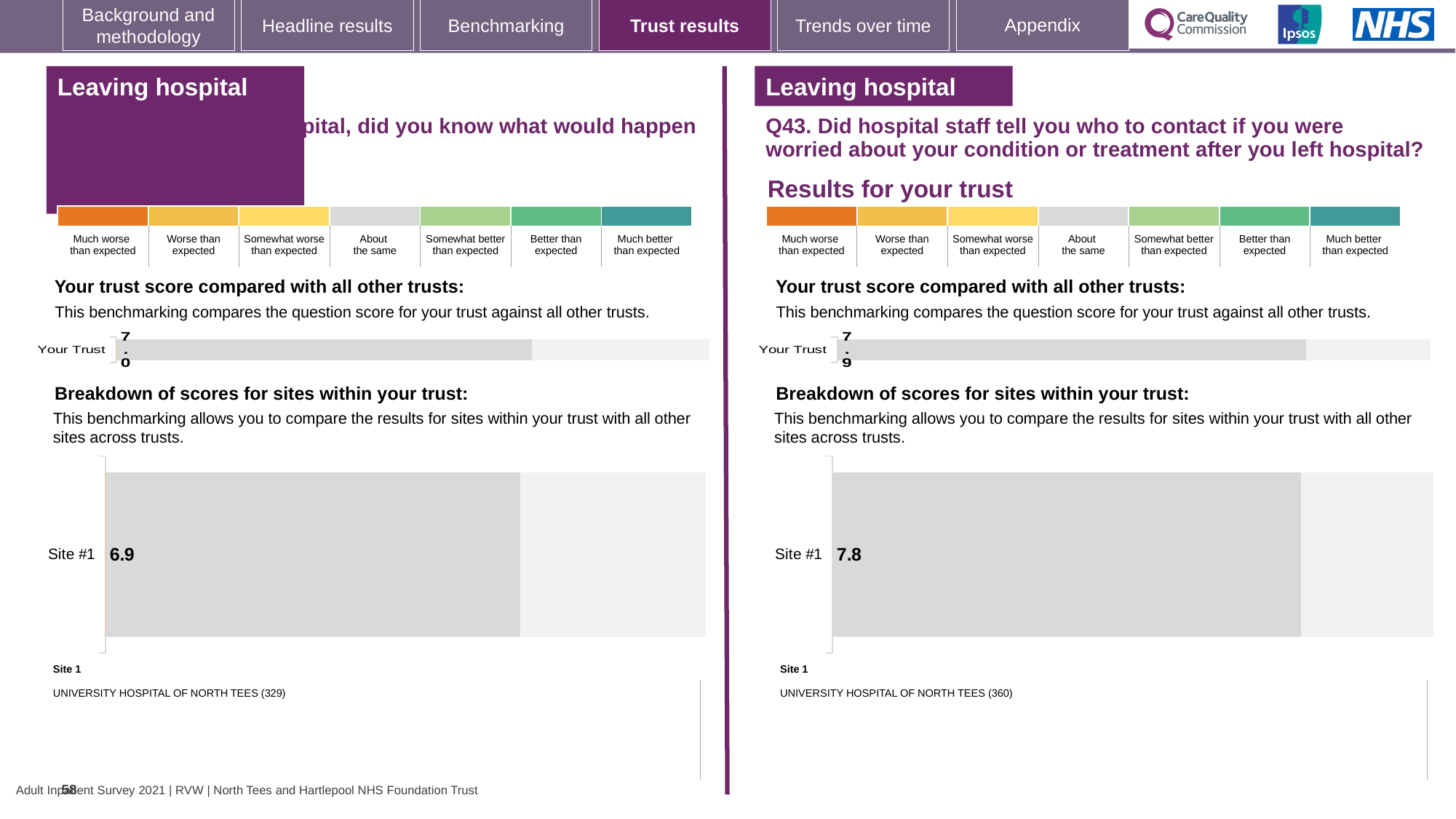
On the left-hand 'Breakdown of scores for sites within your trust' chart, what is the score for Site #1? 6.9 What is the name of the site labelled Site 1 on the right-hand (Q43) side of the slide? UNIVERSITY HOSPITAL OF NORTH TEES (360) How many sites are shown in the right-hand (Q43) 'Breakdown of scores for sites within your trust' chart? 1 Which is larger: the Site #1 score on the left-hand chart or the Site #1 score on the right-hand (Q43) chart? Right-hand (Q43) chart On the left-hand 'Your trust score compared with all other trusts' chart, what is the score for Your Trust? 7.0 On the right-hand (Q43) 'Breakdown of scores for sites within your trust' chart, what is the score for Site #1? 7.8 On the right-hand (Q43) side, what is the difference between the Your Trust score and the Site #1 score? 0.1 On the right-hand (Q43) 'Your trust score compared with all other trusts' chart, what is the score for Your Trust? 7.9 On the left-hand side, what is the difference between the Your Trust score and the Site #1 score? 0.1 What is the name of the site labelled Site 1 on the left-hand side of the slide? UNIVERSITY HOSPITAL OF NORTH TEES (329) What kind of chart is the left-hand 'Breakdown of scores for sites within your trust' chart? Bar chart